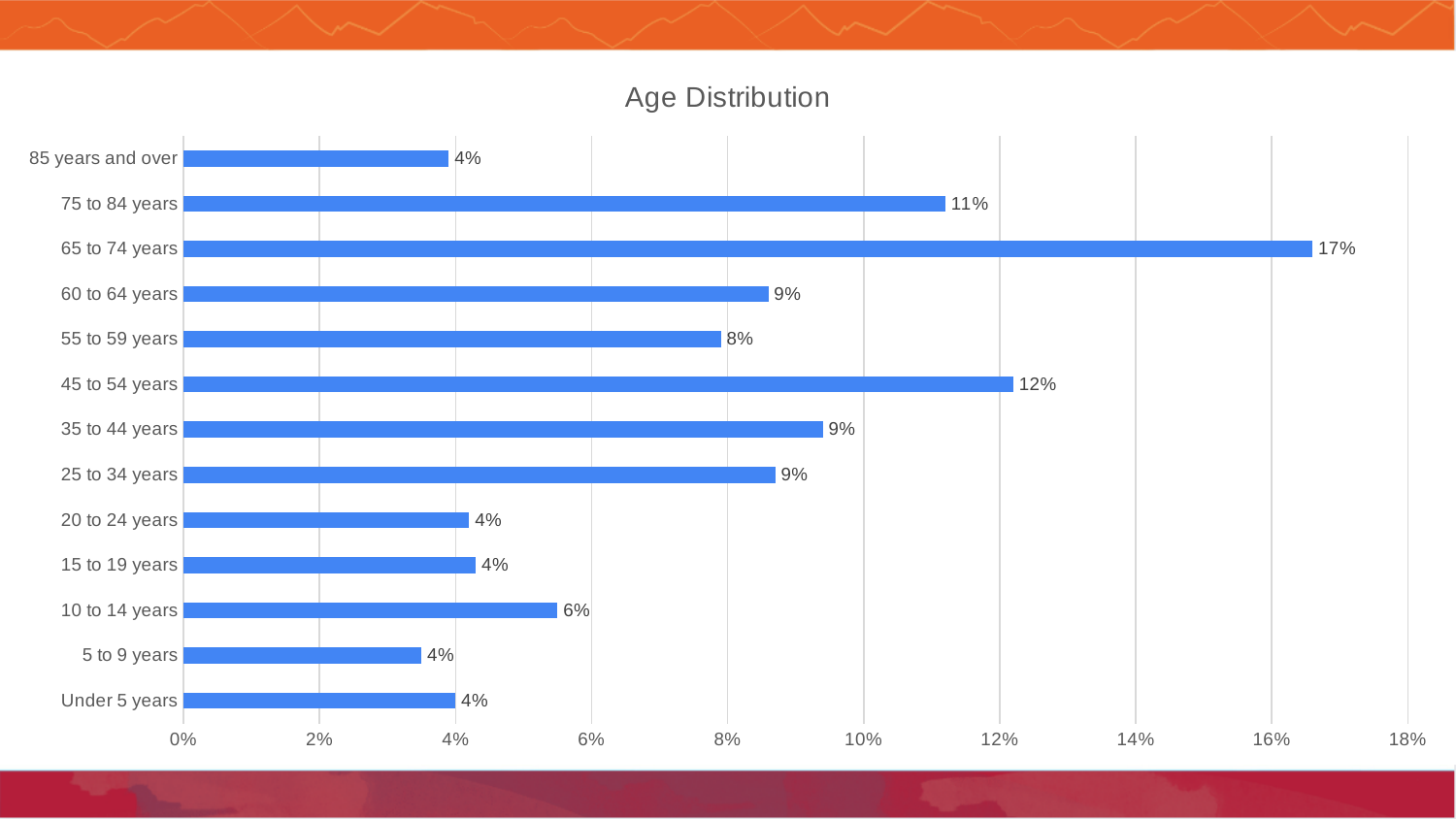
What is the value for 55 to 59 years? 8% What is the value for 45 to 54 years? 12% How many age groups are shown in the chart? 13 What is the difference between the values for 65 to 74 years and 45 to 54 years? 5% What is the value for 10 to 14 years? 6% What is the title of the chart? Age Distribution Which age group has the highest value? 65 to 74 years Is the value for 65 to 74 years greater or less than 16%? greater Which is larger, the value for 45 to 54 years or the value for 75 to 84 years? 45 to 54 years What kind of chart is shown on the slide? bar chart What is the value for 75 to 84 years? 11% What is the value for 65 to 74 years? 17%